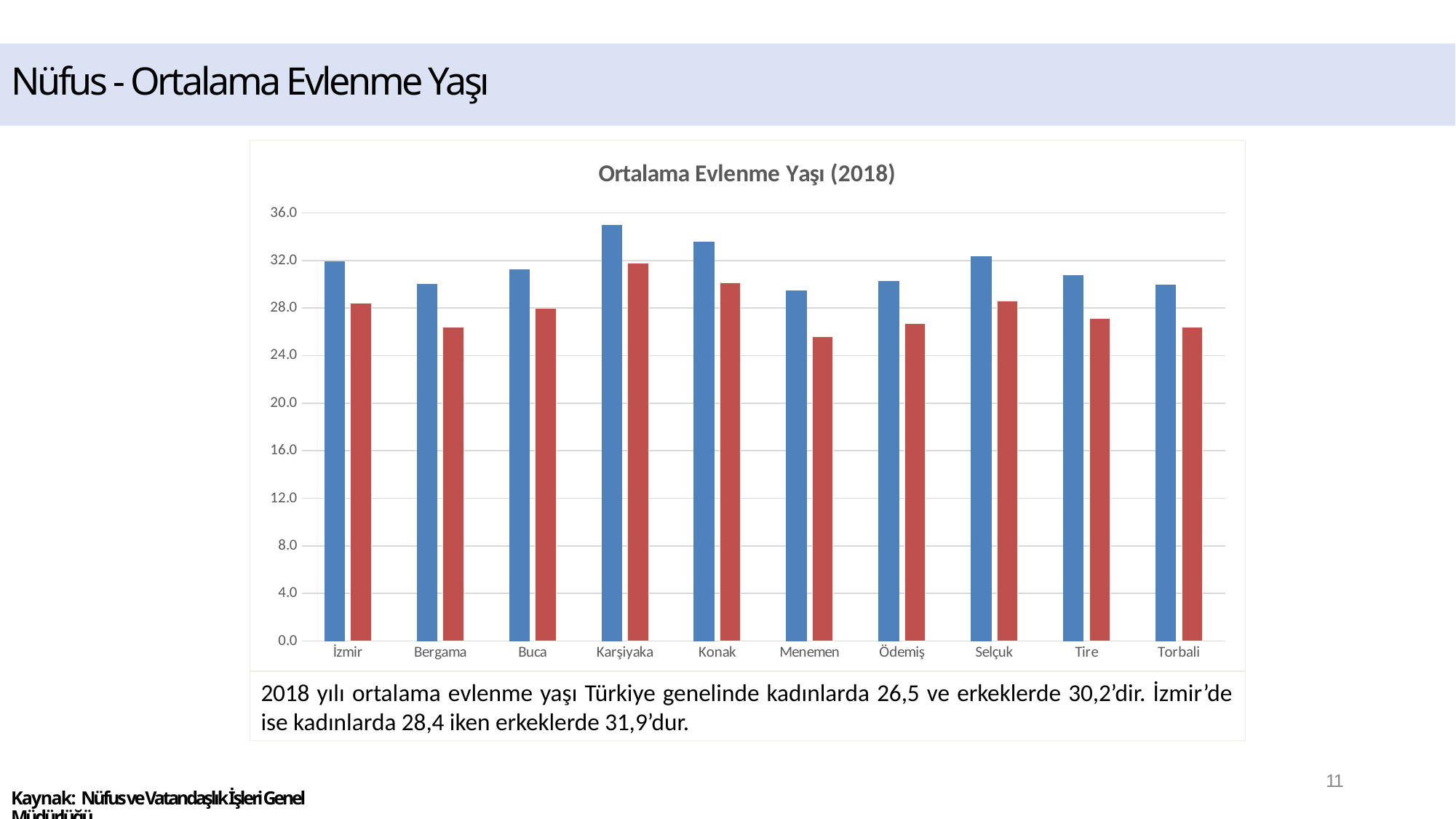
Is the red bar for Menemen greater or less than 28.0? less How many categories (districts) are shown on the x axis of the chart? 10 What is the title of the chart? Ortalama Evlenme Yaşı (2018) Is the red bar for Tire greater or less than 28.0? less Which is larger, the blue bar for Karşiyaka or the blue bar for Konak? Karşiyaka Which category has the highest red bar in the chart? Karşiyaka Which is larger, the red bar for Buca or the red bar for Bergama? Buca How many bars are plotted for each category in the chart? 2 Is the blue bar for Konak greater or less than 32.0? greater Which category has the highest blue bar in the chart? Karşiyaka What kind of chart is shown on the slide? bar chart